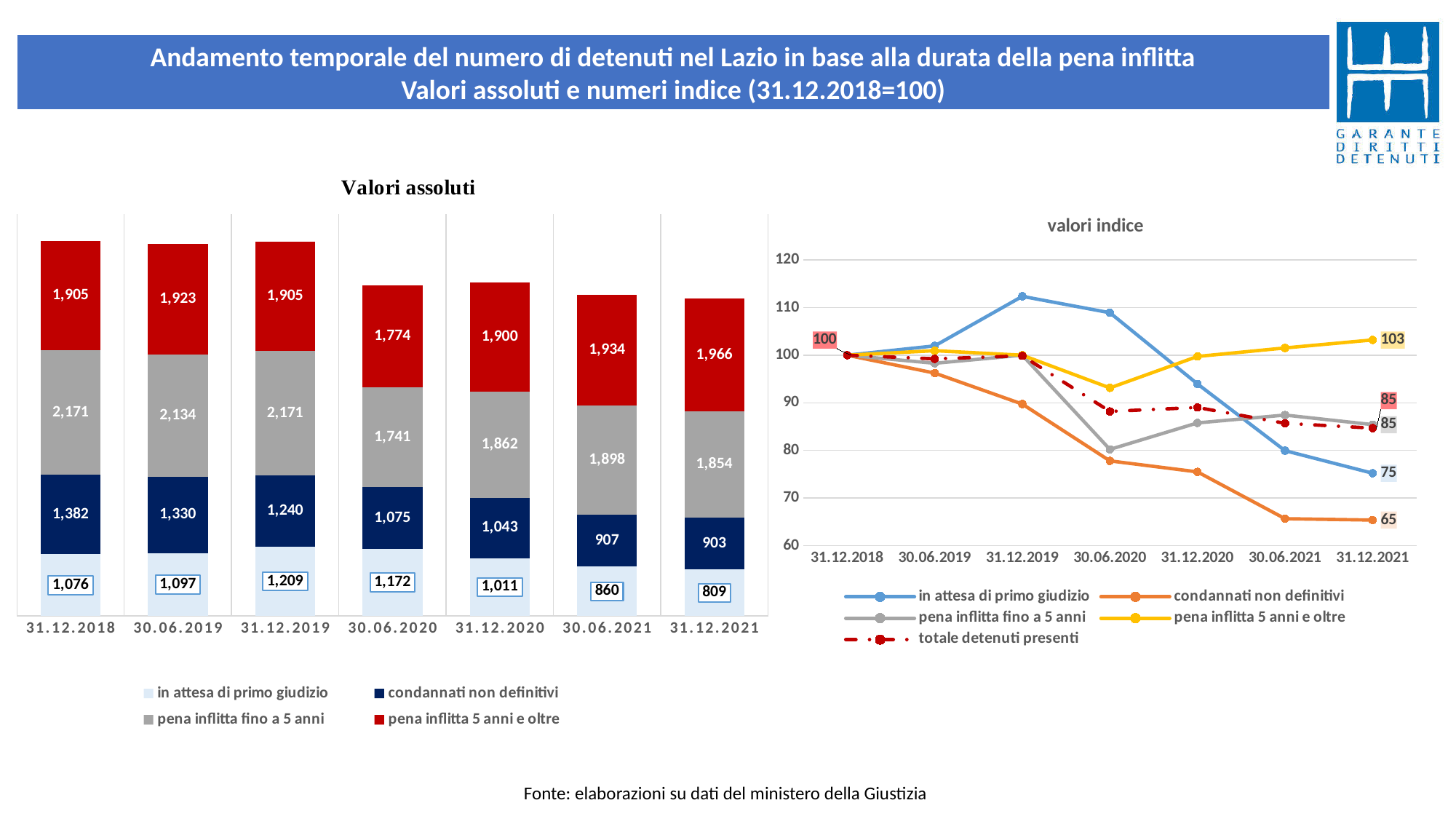
In the 'Valori assoluti' chart, what is the total of the stacked bar for 31.12.2018? 6,534 In the 'Valori assoluti' chart, what is the total of the stacked bar for 31.12.2021? 5,532 In the 'Valori assoluti' chart, what is the value for 'in attesa di primo giudizio' at 31.12.2019? 1,209 In the 'Valori assoluti' chart, at which date is the 'in attesa di primo giudizio' value lowest? 31.12.2021 In the 'valori indice' chart, is the value for 'in attesa di primo giudizio' at 31.12.2019 greater or less than 110? greater What kind of chart is the 'Valori assoluti' chart? Stacked bar chart In the 'valori indice' chart, what is the value for 'condannati non definitivi' at 31.12.2021? 65 In the 'Valori assoluti' chart, what is the difference between the 'pena inflitta fino a 5 anni' values at 31.12.2018 and 30.06.2020? 430 In the 'Valori assoluti' chart, what is the value for 'pena inflitta 5 anni e oltre' at 31.12.2021? 1,966 In the 'Valori assoluti' chart, what is the value for 'condannati non definitivi' at 30.06.2020? 1,075 In the 'valori indice' chart, which series has the highest value at 31.12.2021? pena inflitta 5 anni e oltre In the 'Valori assoluti' chart, how many series does the legend list? 4